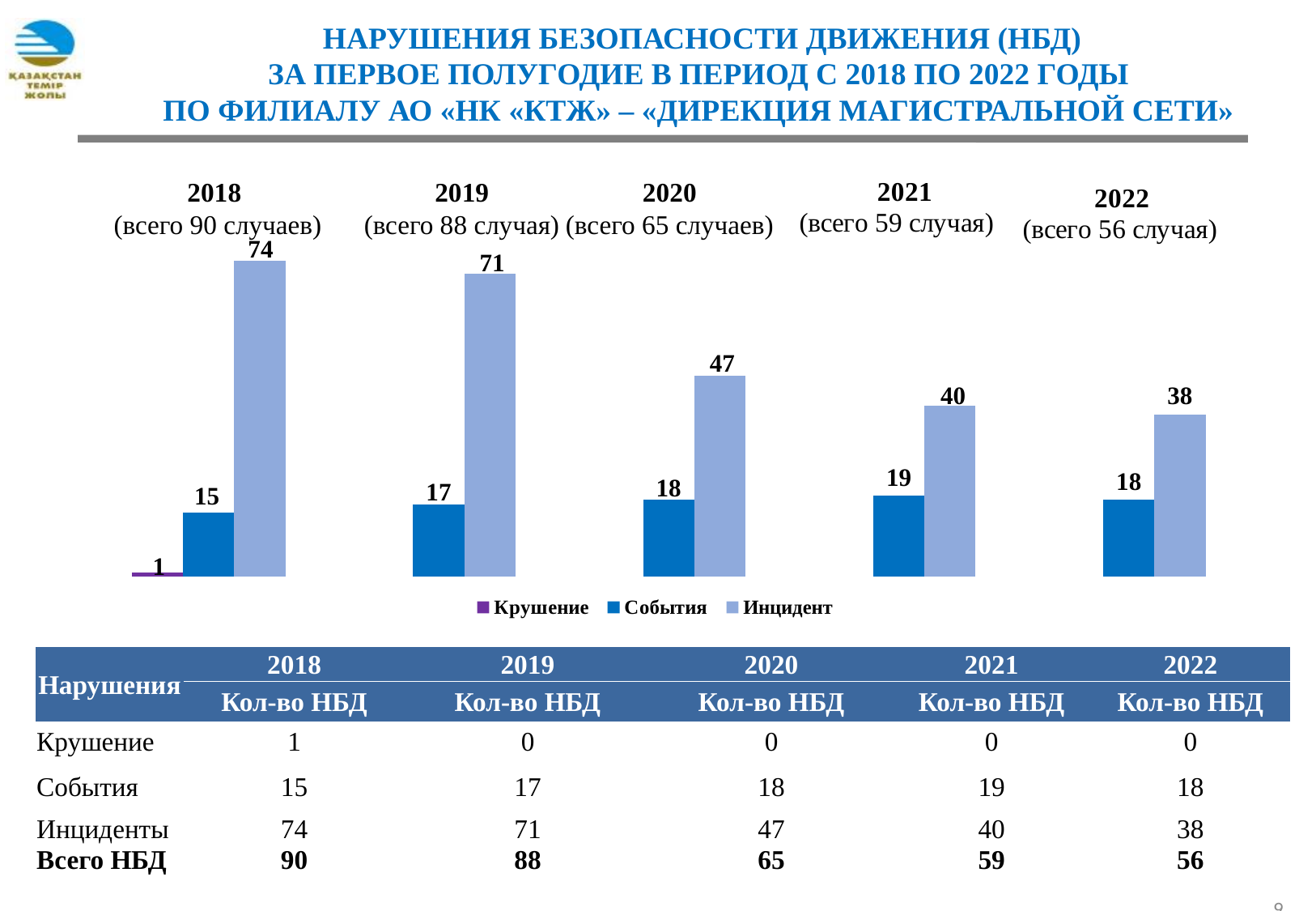
What is the value of События for 2021? 19 What is the difference between the Инцидент values for 2019 and 2020? 24 How many years are shown on the x axis of the chart? 5 Which year has the highest value for Инцидент? 2018 Which series in the legend is shown in purple? Крушение What is the value of Крушение for 2018? 1 What kind of chart is shown on the slide? bar chart What is the value of Инцидент for 2018? 74 How many series does the chart legend list? 3 Which is larger, the События value for 2019 or for 2021? 2021 Which year has the lowest value for Инцидент? 2022 Do the Инцидент values rise or fall from 2018 to 2022? fall